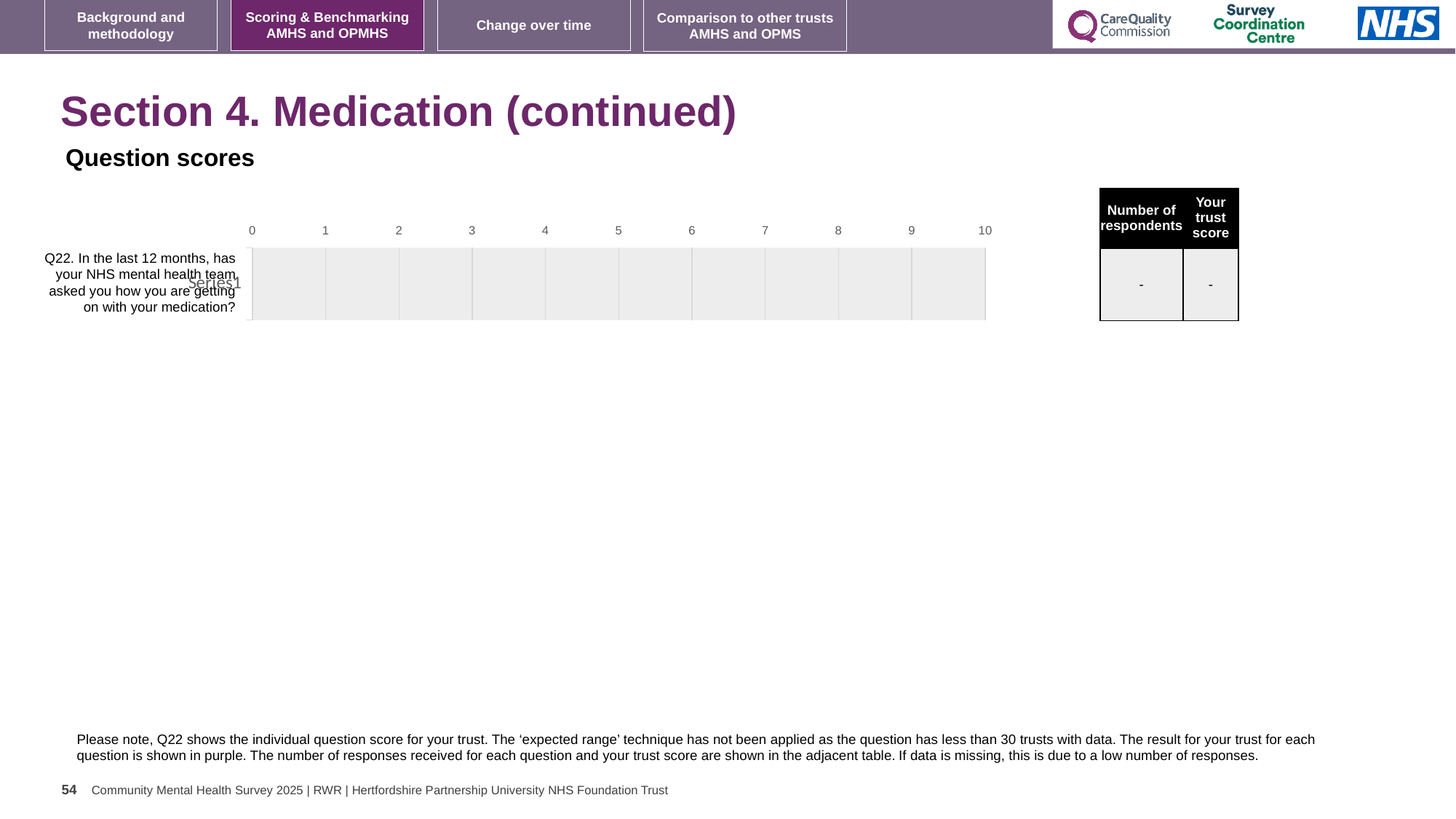
How many questions (categories) are plotted on the chart? 1 What is the highest value shown on the chart's x axis? 10 What trust score is shown in the adjacent table for Q22? - What kind of chart is shown on the slide? bar chart Which question number is plotted on the chart? Q22 What number of respondents is shown in the adjacent table for Q22? -